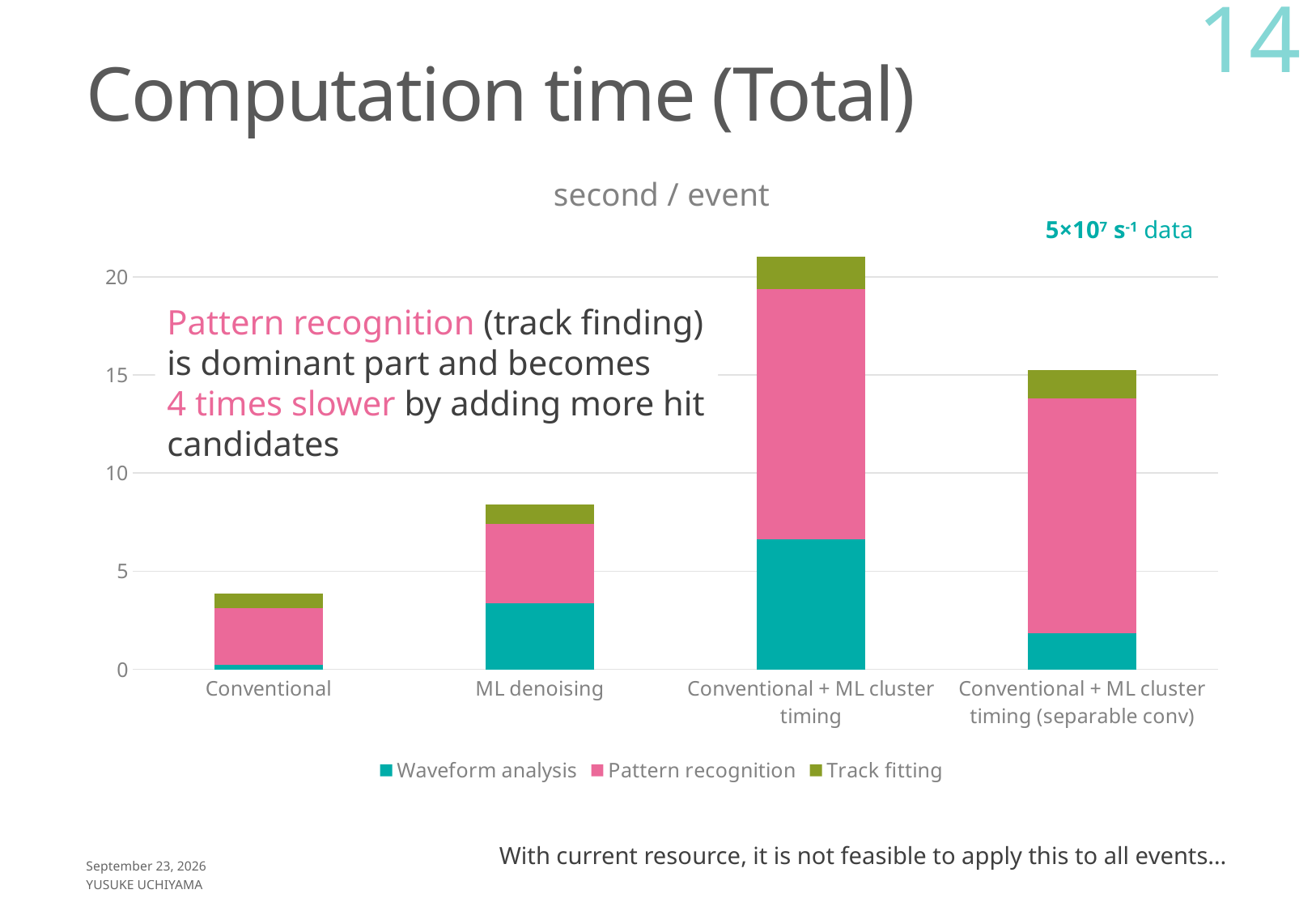
Is the total for Conventional + ML cluster timing greater or less than 20? greater What is the title shown above the chart? second / event Is the total for Conventional + ML cluster timing (separable conv) greater or less than 10? greater Is the total for ML denoising greater or less than 10? less Which category has the highest total computation time? Conventional + ML cluster timing Which series is shown in pink in the chart's legend? Pattern recognition What kind of chart is shown on the slide? Stacked bar chart How many categories are shown on the x axis of the chart? 4 Which has a larger total computation time, ML denoising or Conventional? ML denoising Which category has the lowest total computation time? Conventional How many series does the chart's legend list? 3